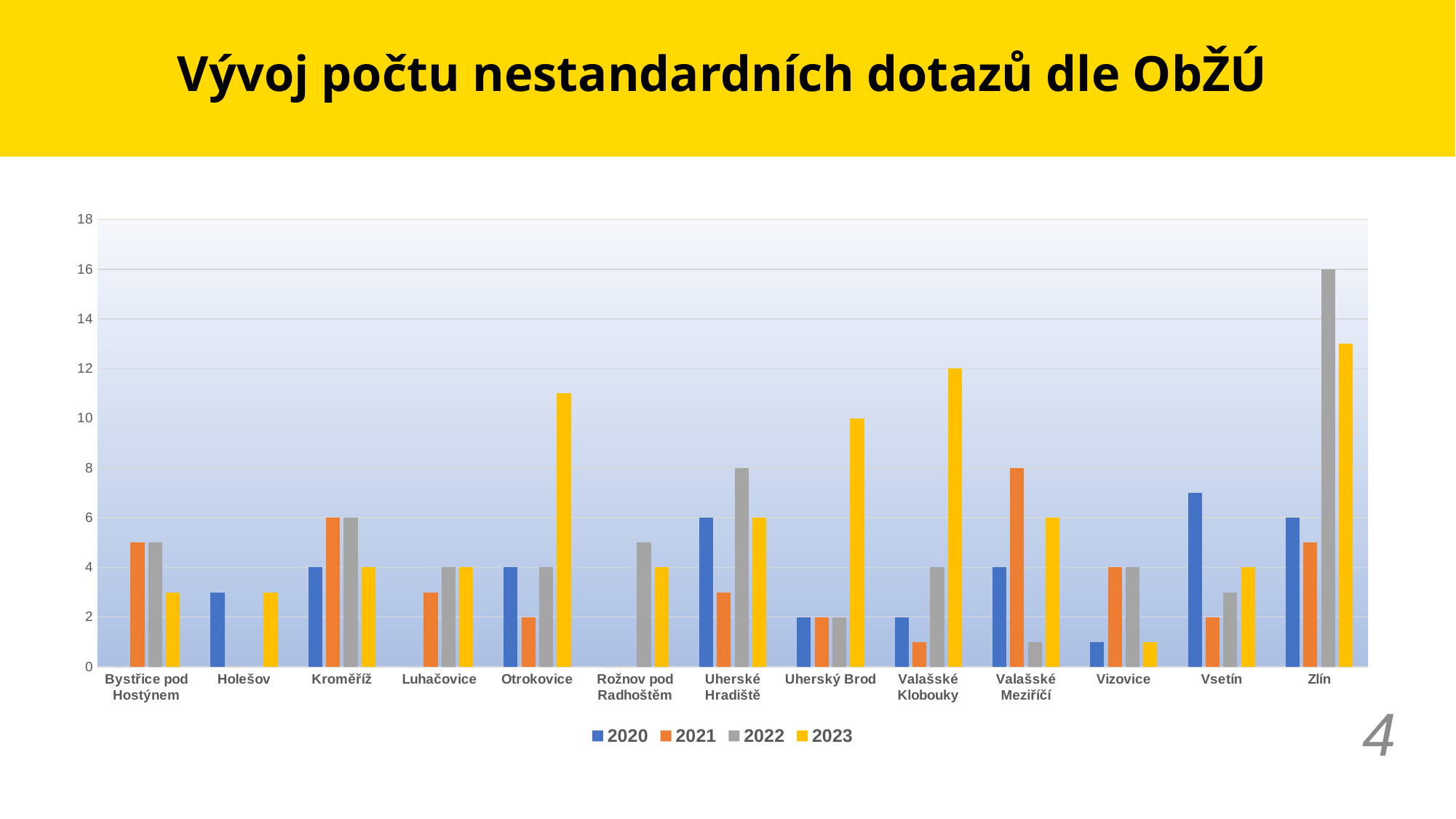
Is the value for Zlín in 2023 greater or less than 12? greater How many categories (municipalities) are shown on the x axis? 13 What colour represents the 2023 series in the legend? yellow What is the value for Uherský Brod in 2023? 10 How many series does the legend list? 4 What is the difference between the 2022 value for Zlín and the 2023 value for Valašské Klobouky? 4 What is the value for Zlín in 2022? 16 For Vsetín, which is larger: the 2020 value or the 2021 value? 2020 What is the value for Valašské Klobouky in 2023? 12 Is the value for Otrokovice in 2023 greater or less than 10? greater What kind of chart is shown on the slide? bar chart Which category has the highest value for 2022? Zlín